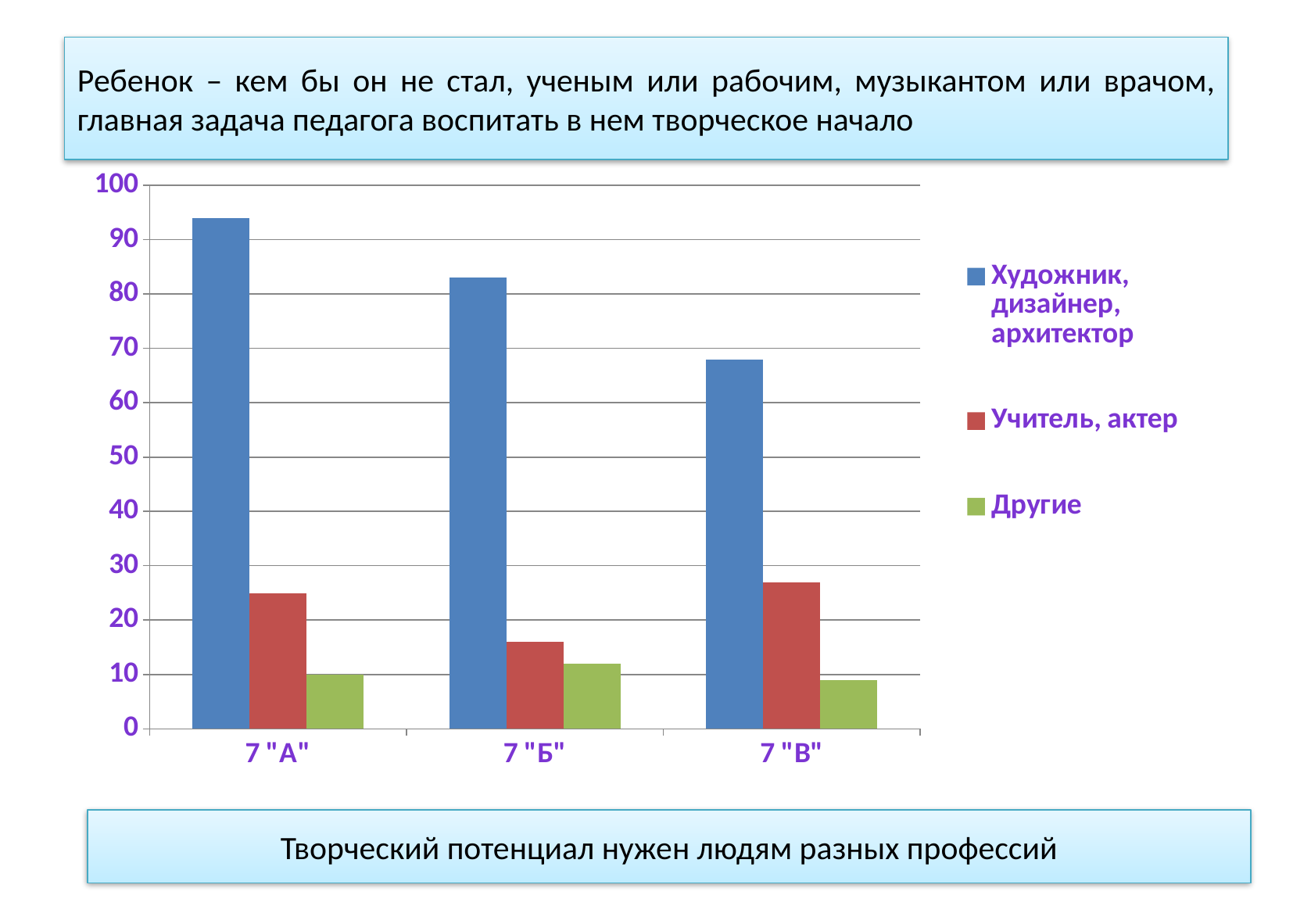
Is the value for "Художник, дизайнер, архитектор" in 7 "А" greater or less than 90? greater Which category has the highest value for the series "Художник, дизайнер, архитектор"? 7 "А" What kind of chart is shown on the slide? bar chart Is the value for "Художник, дизайнер, архитектор" in 7 "В" greater or less than 70? less Does the value for "Художник, дизайнер, архитектор" rise or fall from 7 "А" to 7 "В"? fall Is the value for "Учитель, актер" in 7 "Б" greater or less than 20? less Which is larger: the value for "Учитель, актер" in 7 "В" or in 7 "Б"? 7 "В" Which category has the lowest value for the series "Художник, дизайнер, архитектор"? 7 "В" What colour represents the series "Другие" in the chart? green How many categories are shown on the x axis? 3 How many series does the legend list? 3 Which category has the lowest value for the series "Учитель, актер"? 7 "Б"